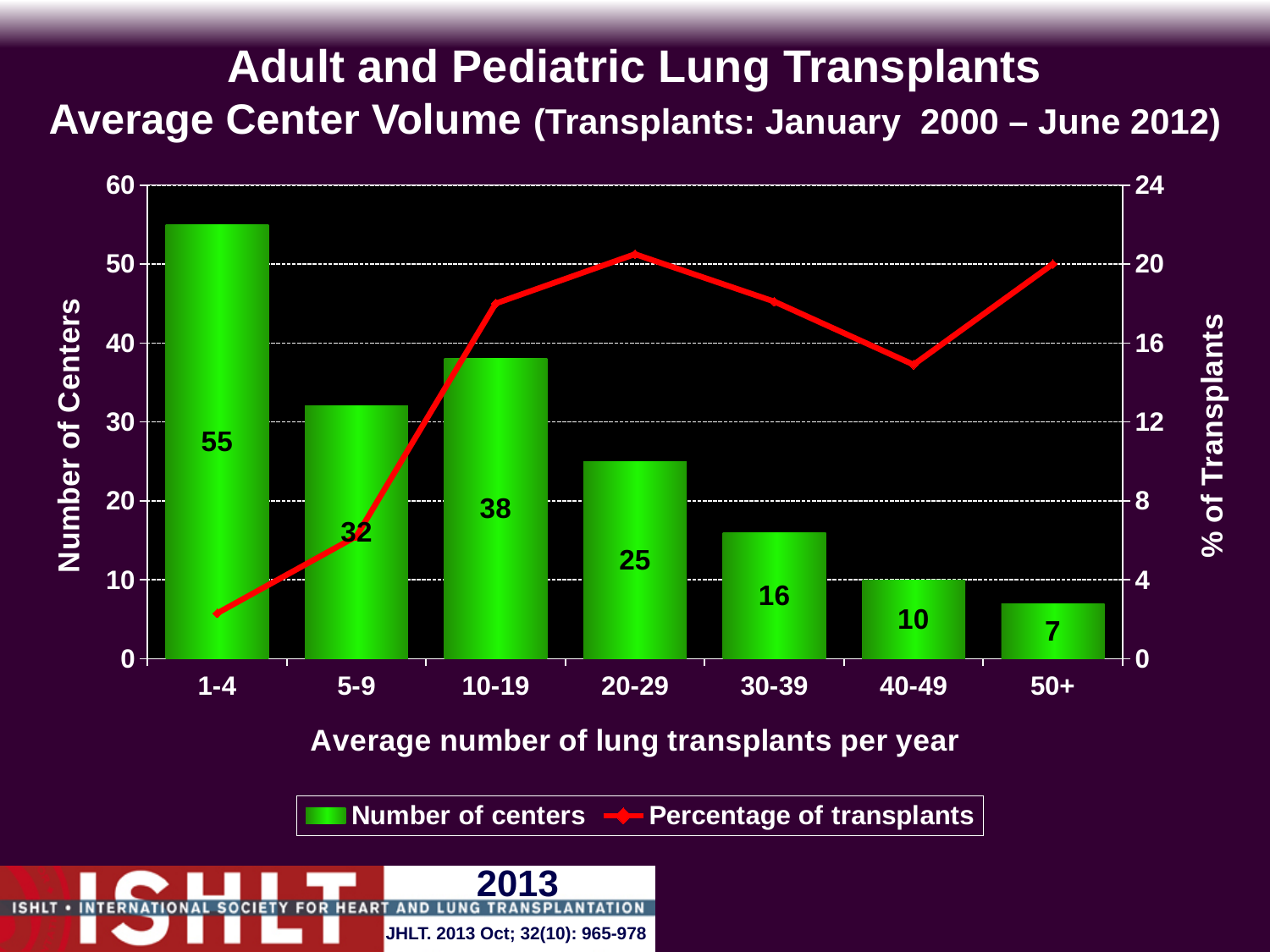
Which category has the highest number of centers? 1-4 Is the percentage of transplants for the 40-49 category greater or less than 16? less Which has more centers, the 5-9 category or the 10-19 category? 10-19 How many centers are in the 1-4 category? 55 How many categories are shown on the x axis? 7 Which category has the lowest number of centers? 50+ Is the percentage of transplants for the 10-19 category greater or less than 16? greater What is the difference in number of centers between the 1-4 and 5-9 categories? 23 What is the number of centers for the 10-19 category? 38 Is the percentage of transplants for the 1-4 category greater or less than 4? less How many series does the legend list? 2 What is the number of centers for the 50+ category? 7